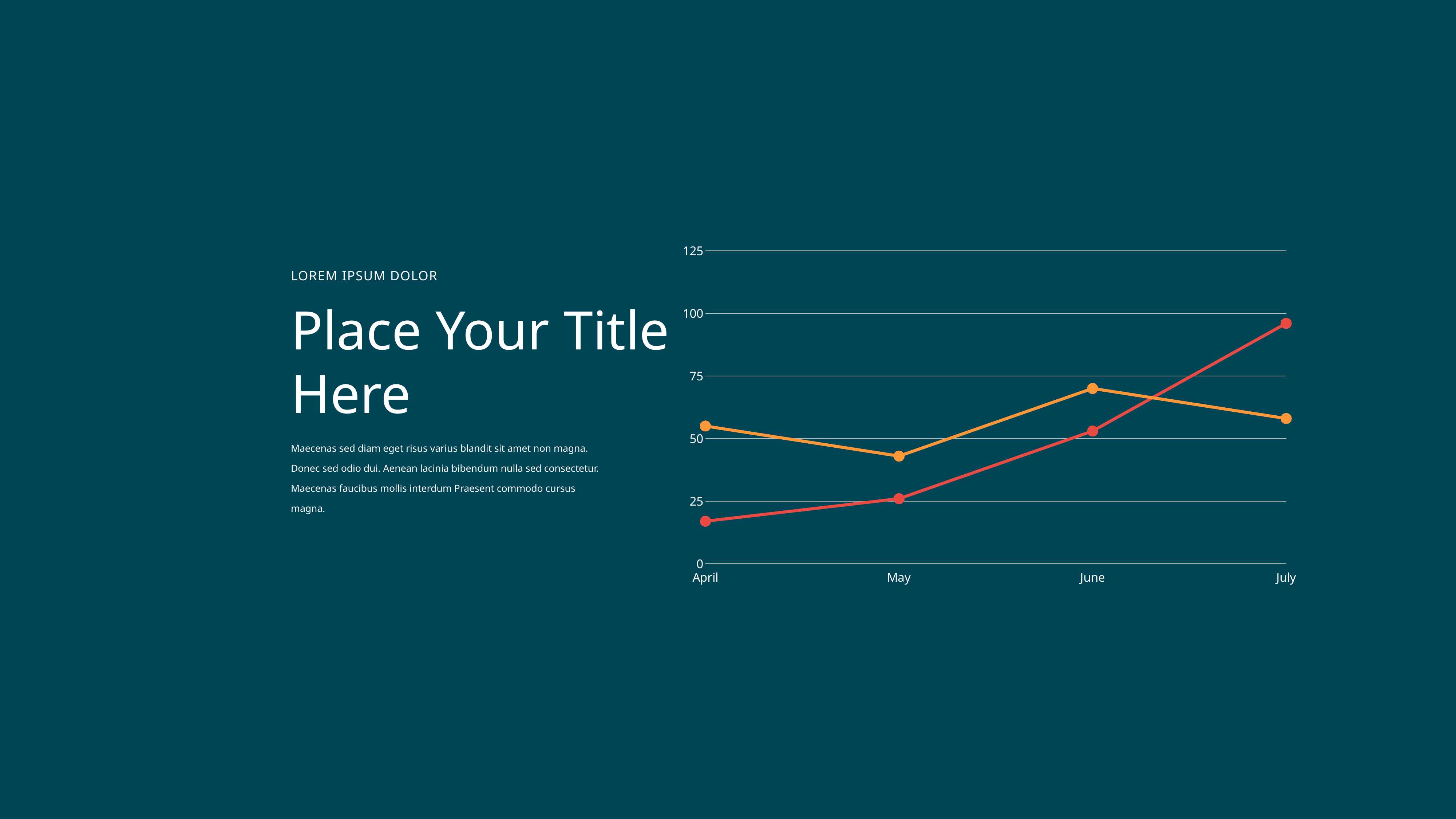
In April, which line has the higher value, the red line or the orange line? orange line Does the red line rise or fall from April to July? rise Is the value of the red line for July greater or less than 75? greater Is the value of the red line for April greater or less than 25? less How many lines are plotted on the chart? 2 How many months are shown on the x axis of the chart? 4 Is the value of the orange line for May greater or less than 50? less What kind of chart is shown on the slide? line chart In which month does the red line reach its highest value? July In July, which line has the higher value, the red line or the orange line? red line In which month does the orange line reach its lowest value? May